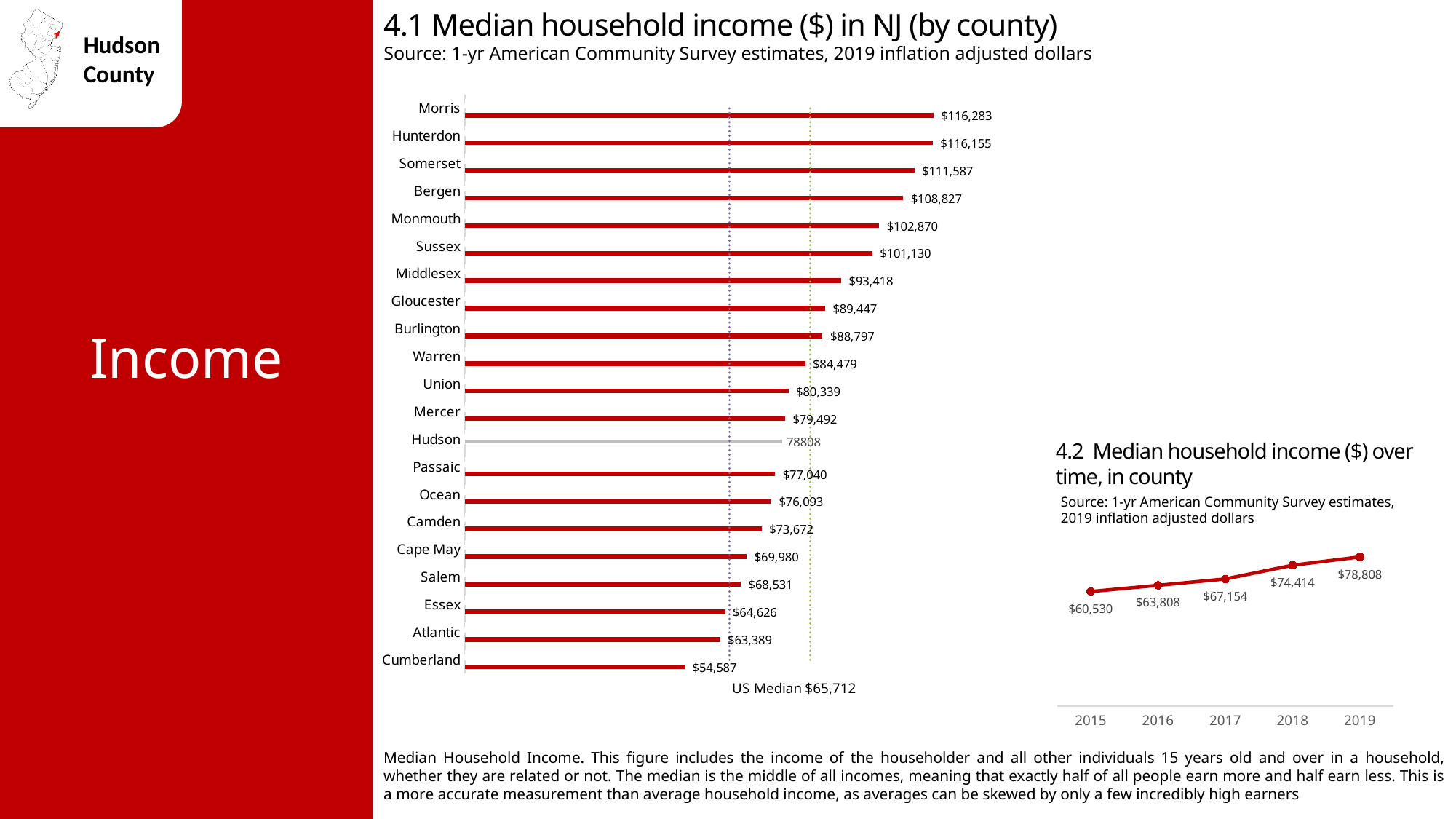
What kind of chart is chart 4.1? Bar chart In chart 4.1, which county has the highest median household income? Morris In chart 4.1, what US Median value is labelled on the chart? $65,712 In chart 4.2 (Median household income over time, in county), what is the value for 2017? $67,154 In chart 4.1, which county has the lowest median household income? Cumberland In chart 4.2, what is the difference between the 2019 and 2015 values? $18,278 In chart 4.1 (Median household income in NJ by county), what is the median household income for Bergen? $108,827 In chart 4.2, do the values rise or fall from 2015 to 2019? Rise In chart 4.1, what is the difference between the median household income of Morris and Cumberland? $61,696 In chart 4.1, how many counties are shown? 21 In chart 4.1, what value is shown for Hudson? 78808 In chart 4.1, which county has a higher median household income, Passaic or Camden? Passaic